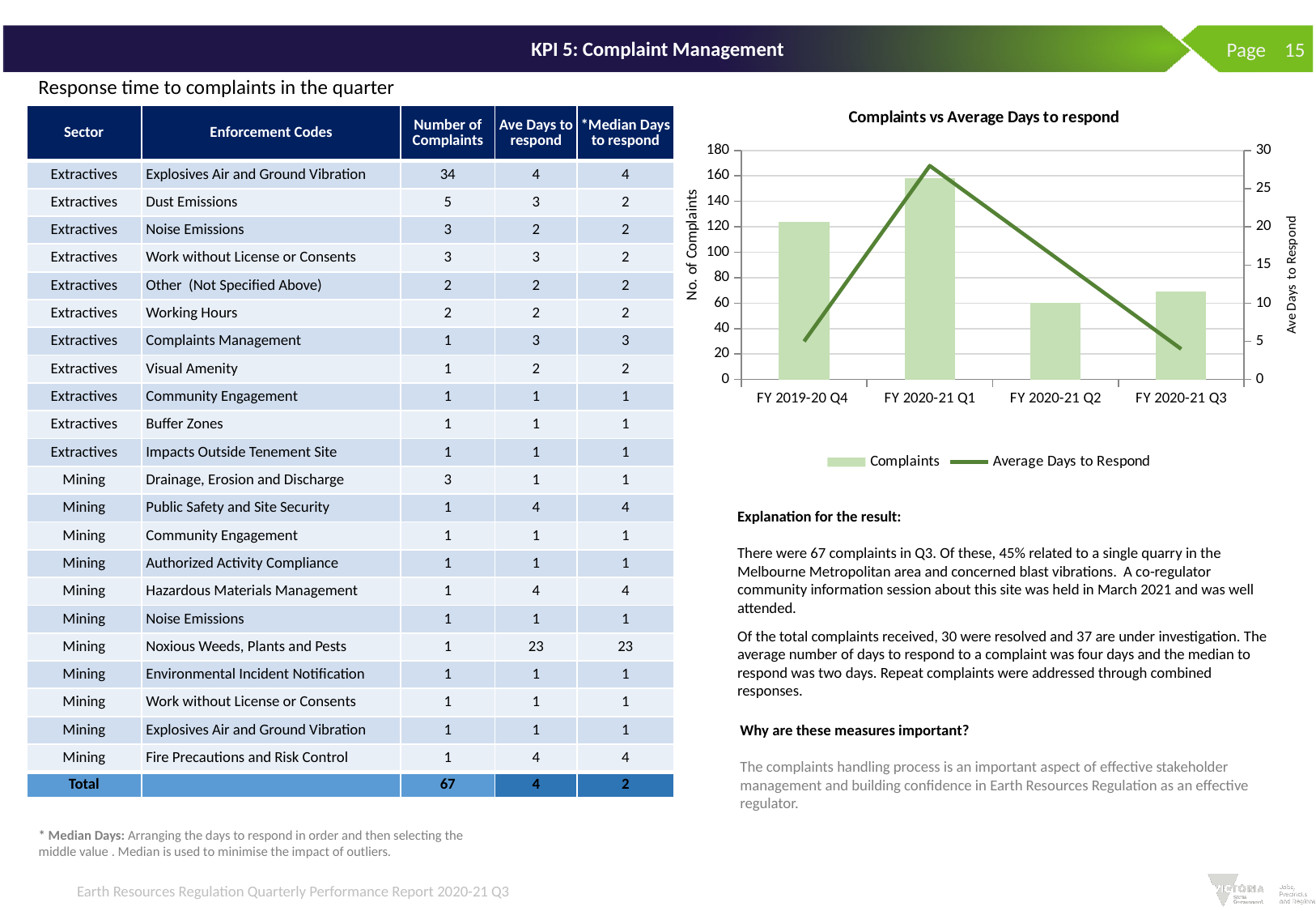
Is the number of complaints for FY 2020-21 Q2 greater or less than 80? less How many quarters are shown on the x axis of the chart? 4 Is the average days to respond for FY 2020-21 Q1 greater or less than 25? greater In which quarter does the Average Days to Respond line reach its peak? FY 2020-21 Q1 How many series does the chart legend list? 2 Which quarter has the lowest number of complaints in the chart? FY 2020-21 Q2 Which quarter has more complaints, FY 2019-20 Q4 or FY 2020-21 Q1? FY 2020-21 Q1 What is the title of the chart on the slide? Complaints vs Average Days to respond Is the number of complaints for FY 2020-21 Q1 greater or less than 140? greater What is the label of the right-hand vertical axis of the chart? Ave Days to Respond Which quarter has the highest number of complaints in the chart? FY 2020-21 Q1